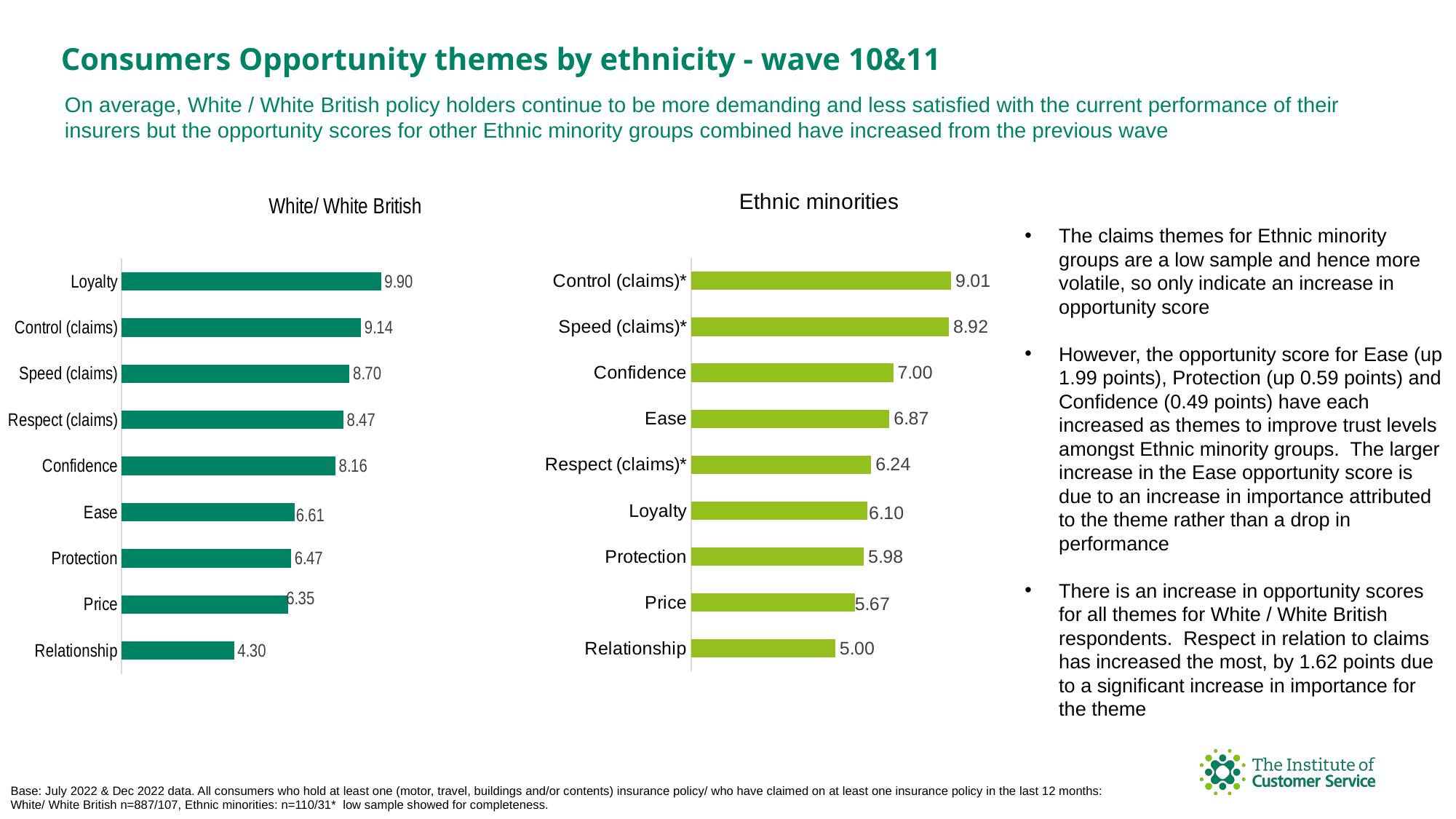
Which is larger: the value for Ease in the 'White/ White British' chart or the value for Ease in the 'Ethnic minorities' chart? Ethnic minorities In the 'White/ White British' chart, which category has the lowest value? Relationship In the 'Ethnic minorities' chart, what is the difference between the values for Confidence and Price? 1.33 What is the title of the chart on the left of the slide? White/ White British In the 'Ethnic minorities' chart, what is the value for Ease? 6.87 In the 'White/ White British' chart, what is the difference between the values for Loyalty and Relationship? 5.60 In the 'White/ White British' chart, what is the value for Loyalty? 9.90 In the 'Ethnic minorities' chart, which category has the highest value? Control (claims)* In the 'Ethnic minorities' chart, what is the value for Relationship? 5.00 How many categories are shown in the 'Ethnic minorities' chart? 9 What kind of chart is the 'White/ White British' chart? Bar chart In the 'White/ White British' chart, which is larger: the value for Confidence or the value for Protection? Confidence